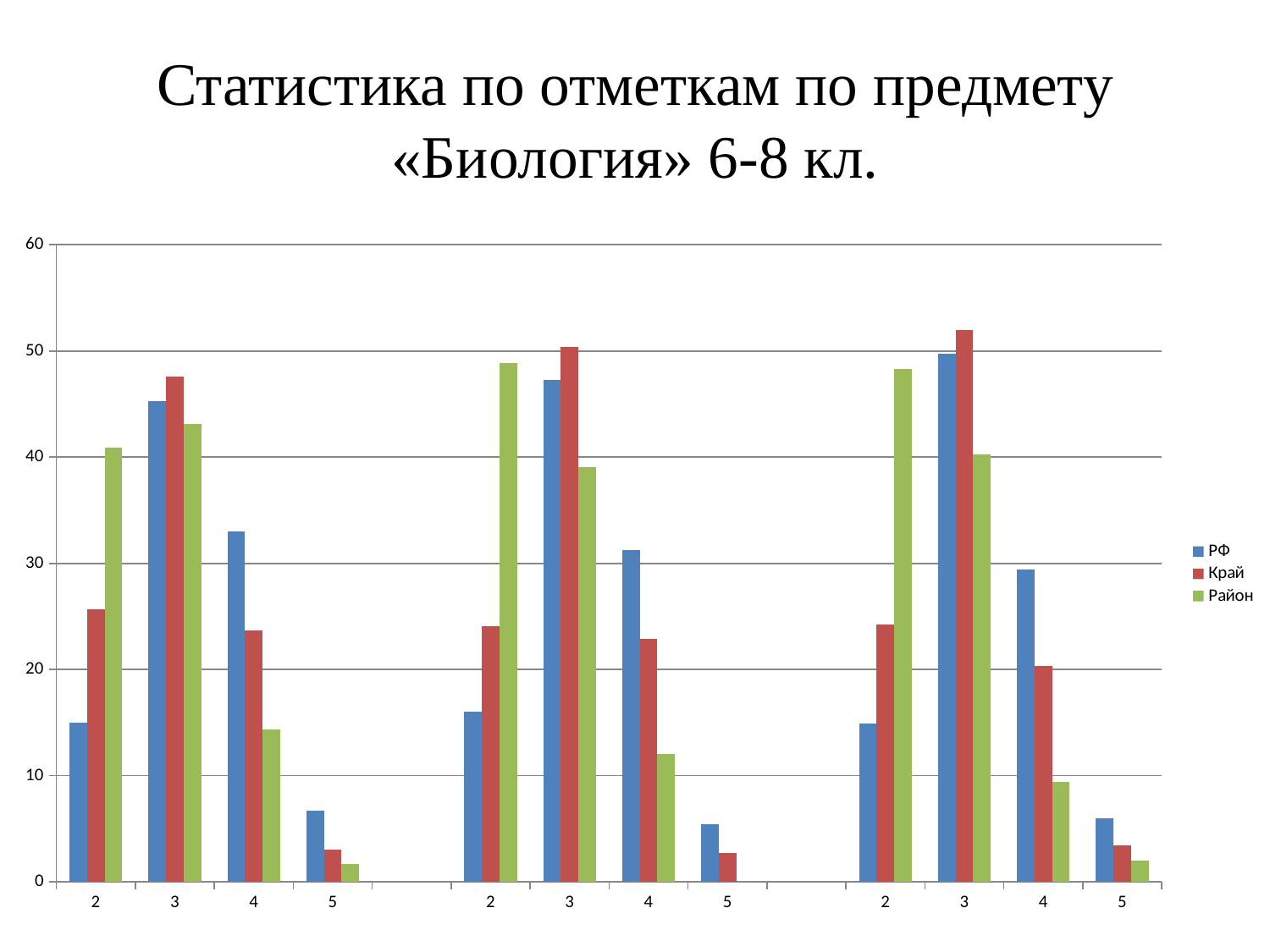
In the leftmost group of bars, is the value of Район for mark 2 greater or less than 30? greater In the middle group of bars, which is larger for mark 3: РФ or Край? Край In the rightmost group of bars, is the value of Край for mark 3 greater or less than 50? greater In the middle group of bars, is the value of Район for mark 4 greater or less than 10? greater How many series does the legend list? 3 What are the series names listed in the legend? РФ, Край, Район In the rightmost group of bars, which series has the highest value for mark 3? Край What is the title of the chart on the slide? Статистика по отметкам по предмету «Биология» 6-8 кл. In the middle group of bars, which is larger for mark 2: Край or Район? Район In the leftmost group of bars, which series has the lowest value for mark 5? Район What kind of chart is shown on the slide? bar chart